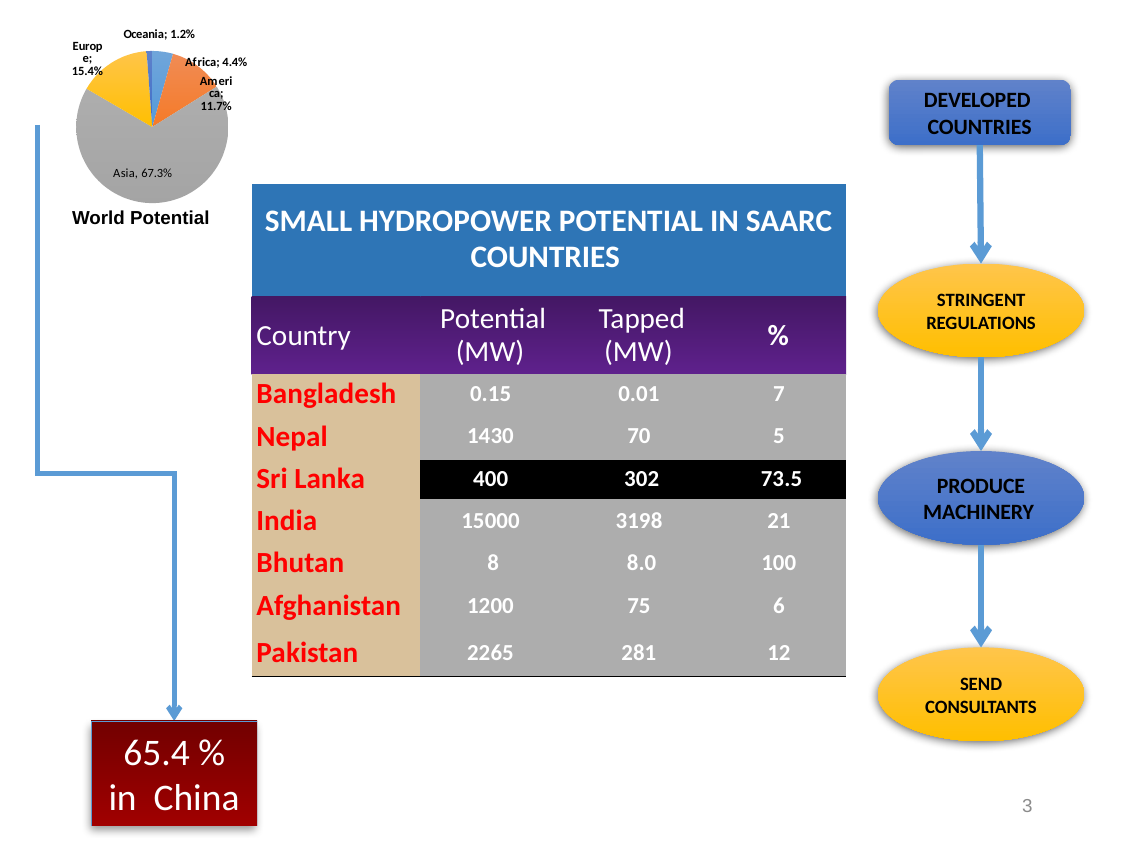
In the "World Potential" pie chart, what share does America have? 11.7% In the "World Potential" pie chart, what share does Africa have? 4.4% In the "World Potential" pie chart, what share does Asia have? 67.3% What kind of chart is the "World Potential" chart? pie chart In the "World Potential" pie chart, which is larger, Europe or America? Europe In the "World Potential" pie chart, what share does Europe have? 15.4% Which region has the smallest slice in the "World Potential" pie chart? Oceania In the "World Potential" pie chart, what share does Oceania have? 1.2% In the "World Potential" pie chart, what is the difference between Asia's share and Europe's share? 51.9% What is the title of the pie chart on the slide? World Potential Which region has the largest slice in the "World Potential" pie chart? Asia How many slices does the "World Potential" pie chart have? 5